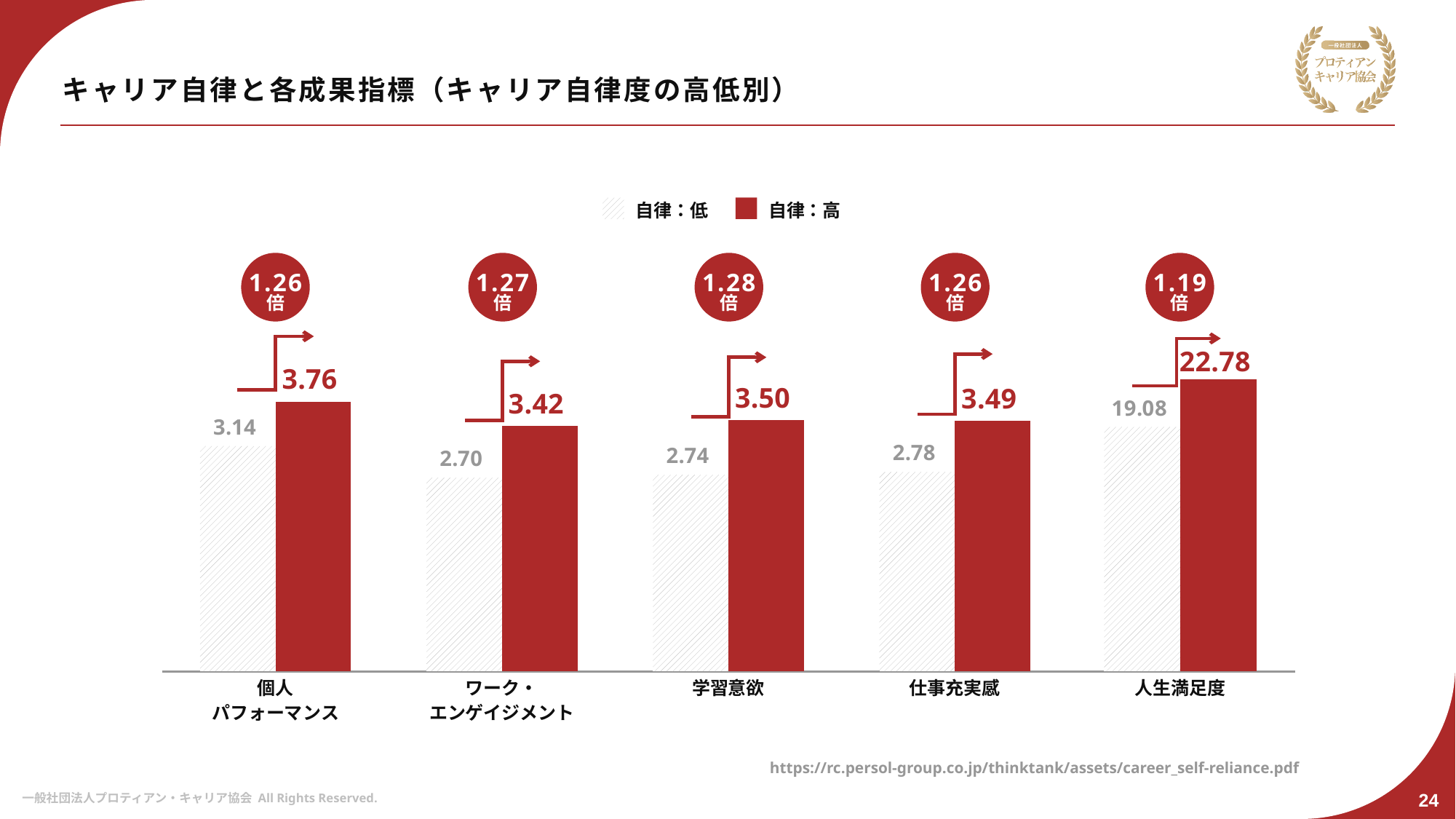
What ratio (倍) is shown above the 学習意欲 category? 1.28倍 What is the difference between the 自律：高 and 自律：低 values for 学習意欲? 0.76 What is the value for 自律：高 in the 人生満足度 category? 22.78 How many series does the legend list? 2 How many categories are shown on the x axis? 5 Which category has the lowest ratio (倍) shown above the bars? 人生満足度 What kind of chart is shown on the slide? Bar chart Which is larger for 仕事充実感: the 自律：高 value or the 自律：低 value? 自律：高 Which category has the highest ratio (倍) shown above the bars? 学習意欲 What is the value for 自律：高 in the 個人パフォーマンス category? 3.76 What is the value for 自律：低 in the ワーク・エンゲイジメント category? 2.70 What is the value for 自律：低 in the 仕事充実感 category? 2.78